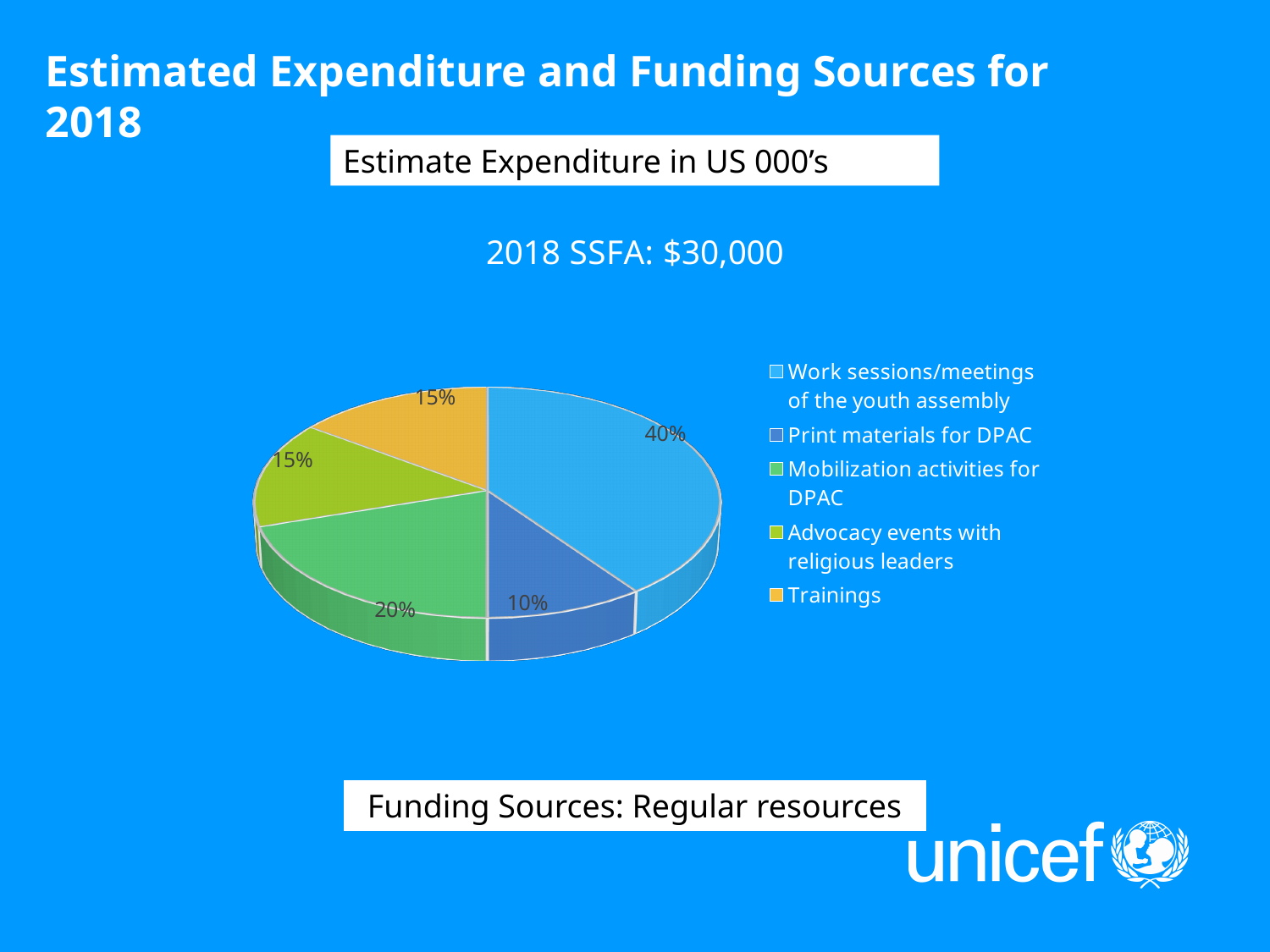
What kind of chart is shown on the slide? pie chart What share of the pie is Trainings? 15% What share of the pie is Advocacy events with religious leaders? 15% How many categories does the pie chart show? 5 Which is larger, the share for Mobilization activities for DPAC or the share for Print materials for DPAC? Mobilization activities for DPAC What is the difference between the shares for Work sessions/meetings of the youth assembly and Mobilization activities for DPAC? 20% What is the combined share of Advocacy events with religious leaders and Trainings? 30% What share of the pie is Mobilization activities for DPAC? 20% Which category has the largest slice of the pie? Work sessions/meetings of the youth assembly What total amount is stated above the pie chart for the 2018 SSFA? $30,000